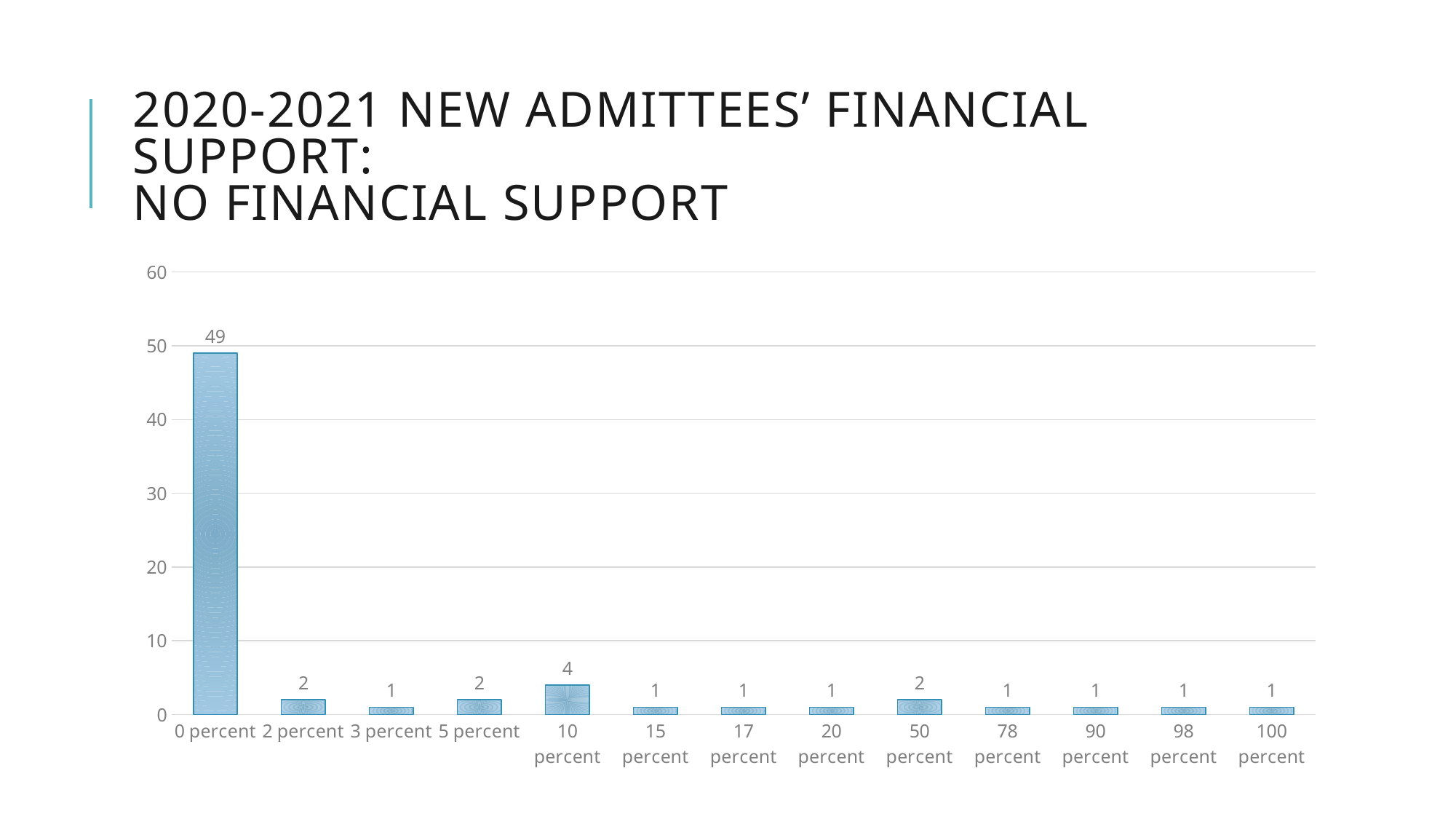
What kind of chart is shown on the slide? Bar chart Which category has the highest value? 0 percent Is the value for 0 percent greater or less than 40? greater What is the value for the 100 percent category? 1 What is the value for the 10 percent category? 4 What is the value for the 0 percent category? 49 What is the highest value shown on the vertical axis? 60 What is the difference between the values for 0 percent and 10 percent? 45 How many categories are shown on the x axis? 13 Which is larger, the value for 10 percent or the value for 5 percent? 10 percent What is the value for the 50 percent category? 2 What is the difference between the values for 10 percent and 2 percent? 2